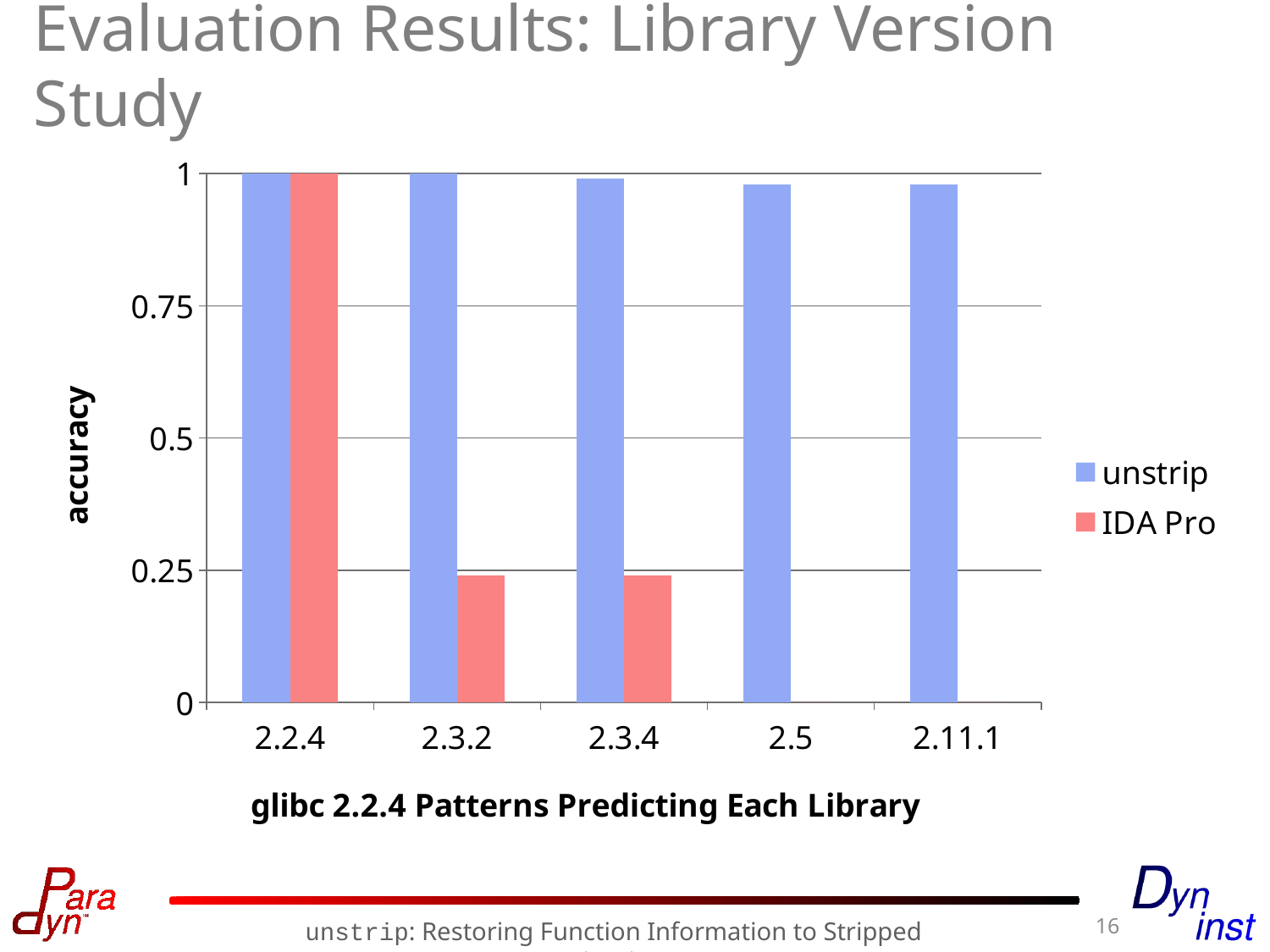
How many series does the chart legend list? 2 Is the accuracy of unstrip for version 2.5 greater or less than 0.75? greater Which series is shown in red in the chart? IDA Pro What is the accuracy of IDA Pro for library version 2.2.4? 1 For version 2.3.4, which has the higher accuracy, unstrip or IDA Pro? unstrip Is the accuracy of IDA Pro for version 2.3.2 greater or less than 0.5? less For which library version does IDA Pro have its highest accuracy? 2.2.4 Is the accuracy of unstrip for version 2.11.1 greater or less than 0.5? greater What kind of chart is shown on the slide? bar chart Does the accuracy of IDA Pro rise or fall as the library versions move from 2.2.4 to 2.3.4 along the x axis? fall How many library versions are shown on the x axis of the chart? 5 What is the label on the y axis of the chart? accuracy